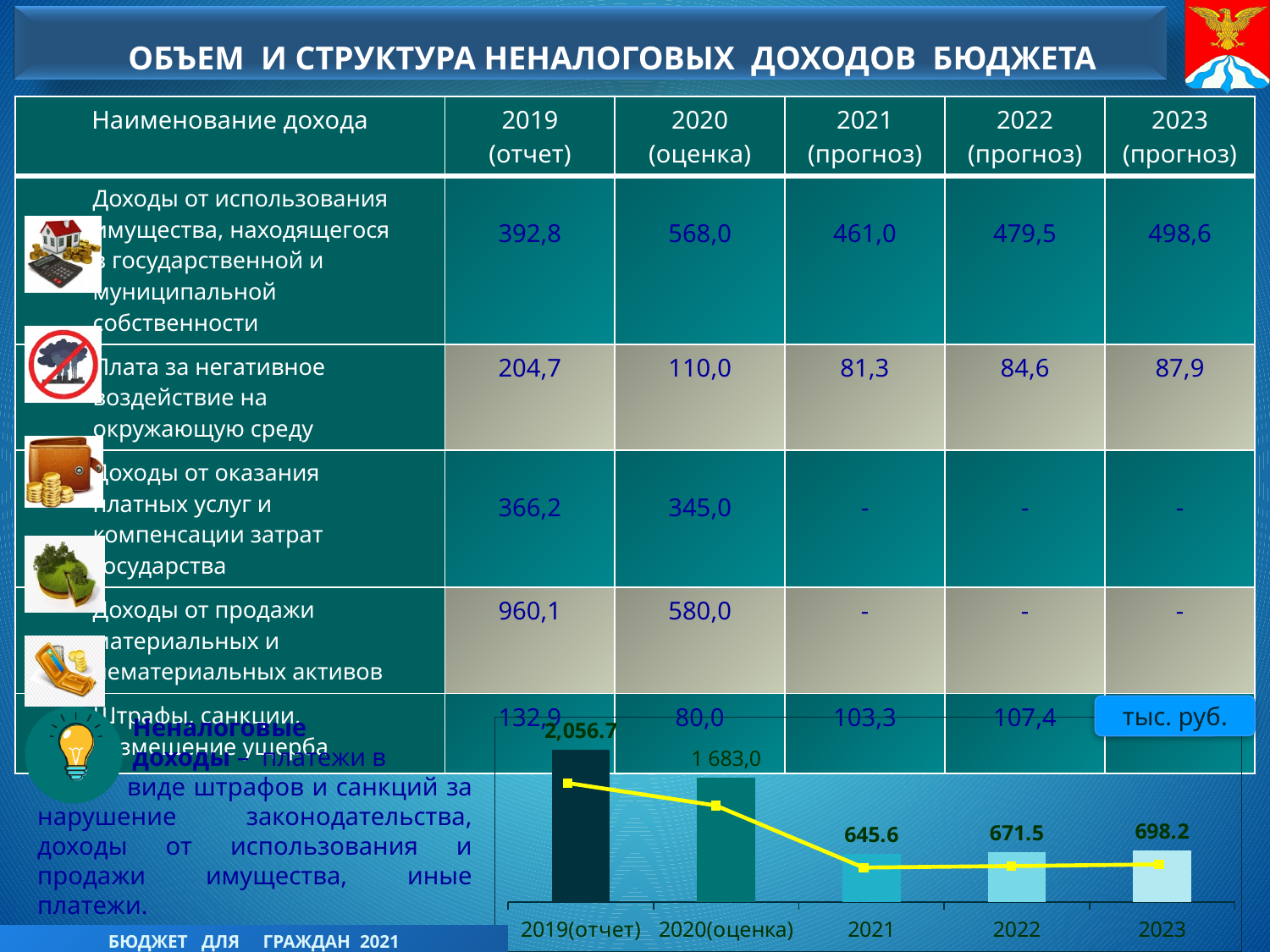
What is the value shown for 2022 in the chart at the bottom of the slide? 671.5 What is the value shown for 2023 in the chart at the bottom of the slide? 698.2 In the chart at the bottom of the slide, which is larger: the value for 2020(оценка) or the value for 2022? 2020(оценка) In the chart at the bottom of the slide, what is the difference between the values for 2023 and 2021? 52.6 Which year has the highest value in the chart at the bottom of the slide? 2019(отчет) What is the value shown for 2020(оценка) in the chart at the bottom of the slide? 1 683,0 In the chart at the bottom of the slide, do the values rise or fall from 2019(отчет) to 2021? fall In the chart at the bottom of the slide, what is the difference between the values for 2022 and 2021? 25.9 What is the value shown for 2021 in the chart at the bottom of the slide? 645.6 How many years (categories) are shown on the x axis of the chart at the bottom of the slide? 5 What is the value shown for 2019(отчет) in the chart at the bottom of the slide? 2,056.7 Which year has the lowest value in the chart at the bottom of the slide? 2021